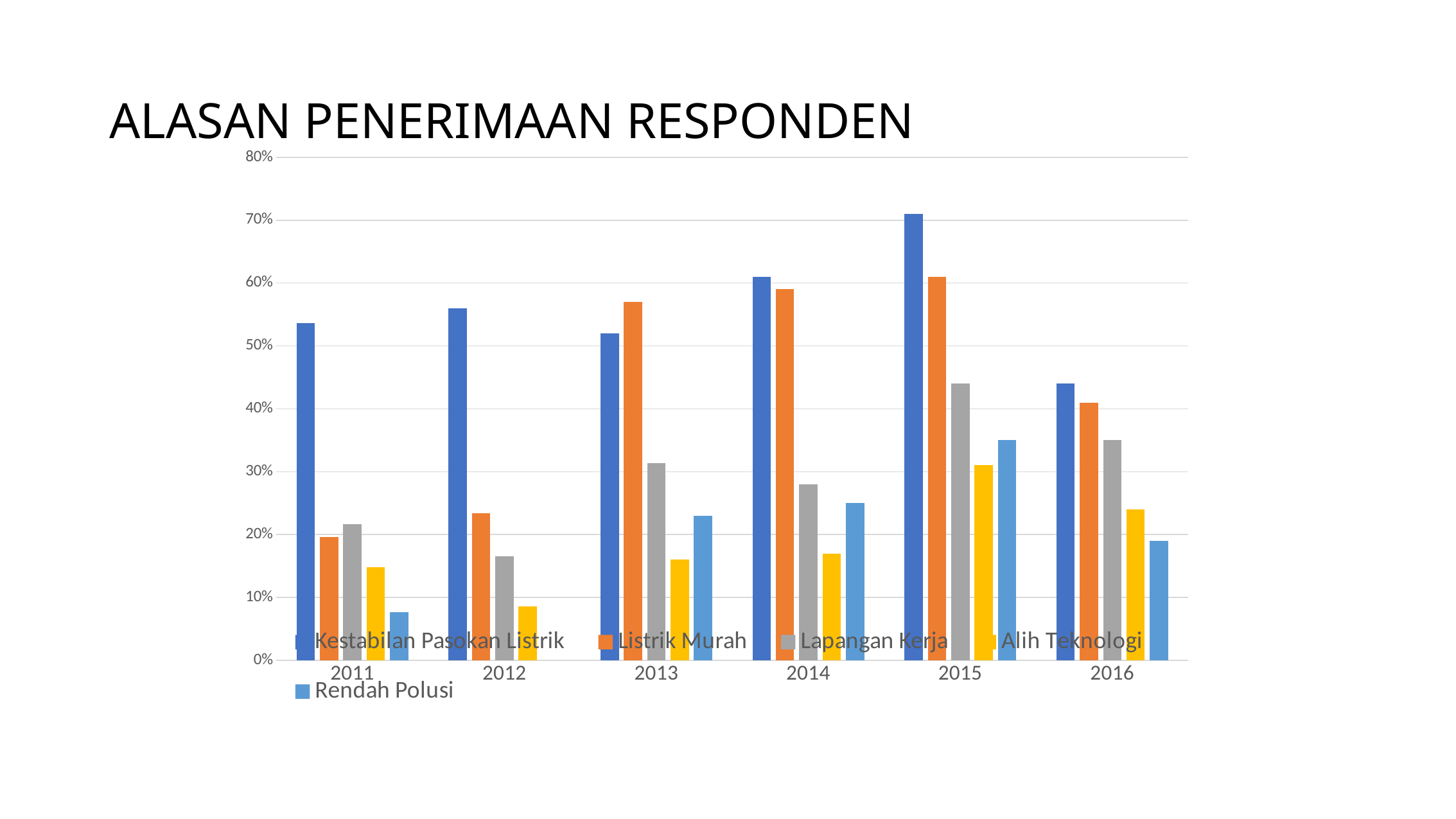
How many series does the legend list? 5 In which year is the value for Kestabilan Pasokan Listrik highest? 2015 What is the title of the chart? ALASAN PENERIMAAN RESPONDEN In which year is the value for Alih Teknologi lowest? 2012 How many years are shown on the x axis? 6 In 2013, which is larger: Listrik Murah or Kestabilan Pasokan Listrik? Listrik Murah In 2016, which is larger: Lapangan Kerja or Alih Teknologi? Lapangan Kerja Is the value for Kestabilan Pasokan Listrik in 2015 greater or less than 60%? greater Is the value for Lapangan Kerja in 2015 greater or less than 40%? greater Does the value for Kestabilan Pasokan Listrik rise or fall from 2015 to 2016? fall Is the value for Rendah Polusi in 2011 greater or less than 10%? less What kind of chart is shown on the slide? bar chart